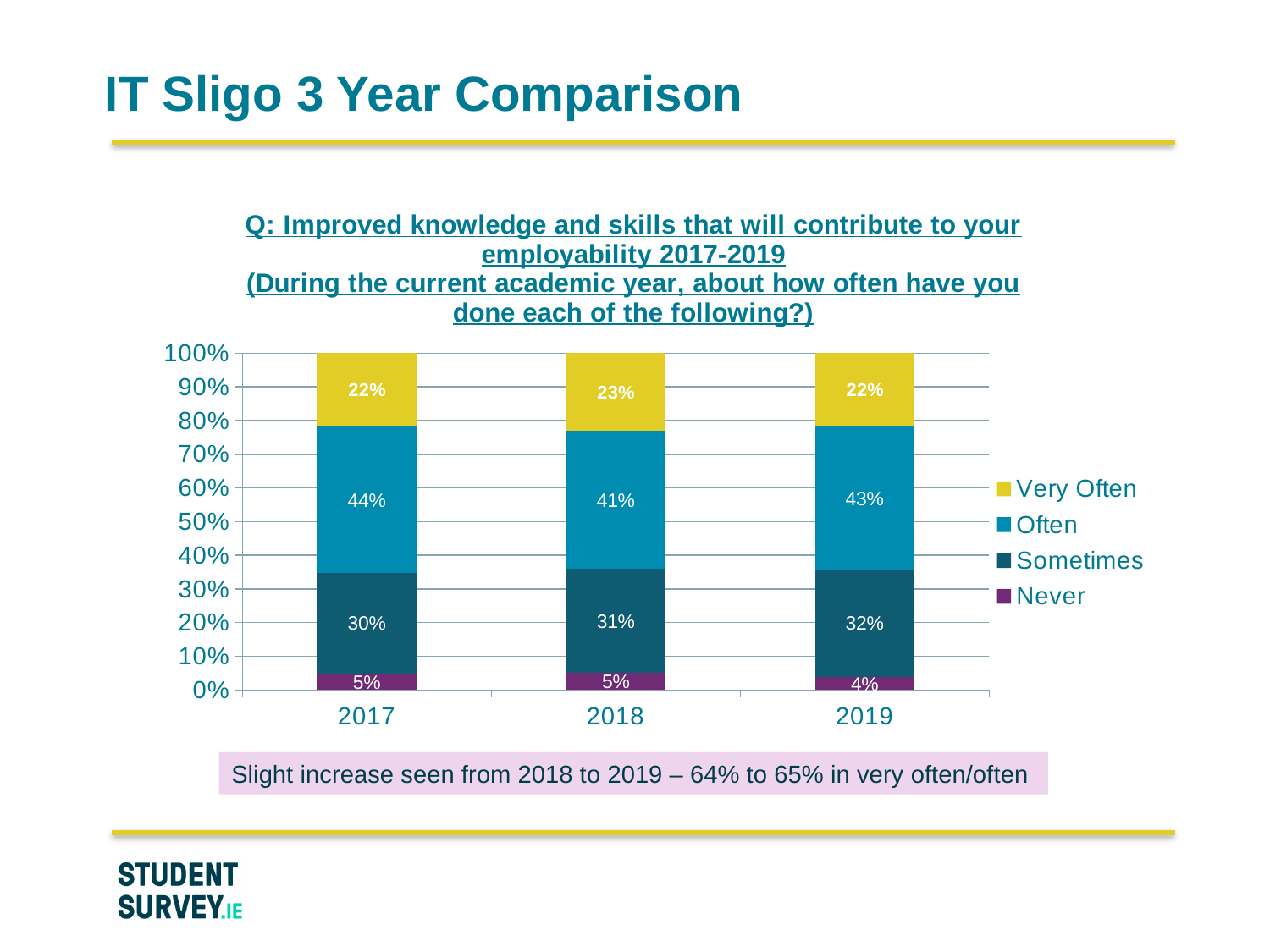
What percentage answered 'Never' in 2019? 4% What is the 'Sometimes' value for 2019? 32% What is the 'Very Often' value for 2018? 23% Is the 'Sometimes' value larger in 2018 or 2019? 2019 Which colour represents 'Very Often' in the legend? Yellow Which year has the lowest 'Never' value? 2019 Which year has the highest 'Often' value? 2017 What kind of chart is shown on the slide? Stacked bar chart How many series does the legend list? 4 How many years are shown on the x axis? 3 What percentage of respondents answered 'Often' in 2017? 44% What is the difference between the 'Often' values for 2017 and 2018? 3%